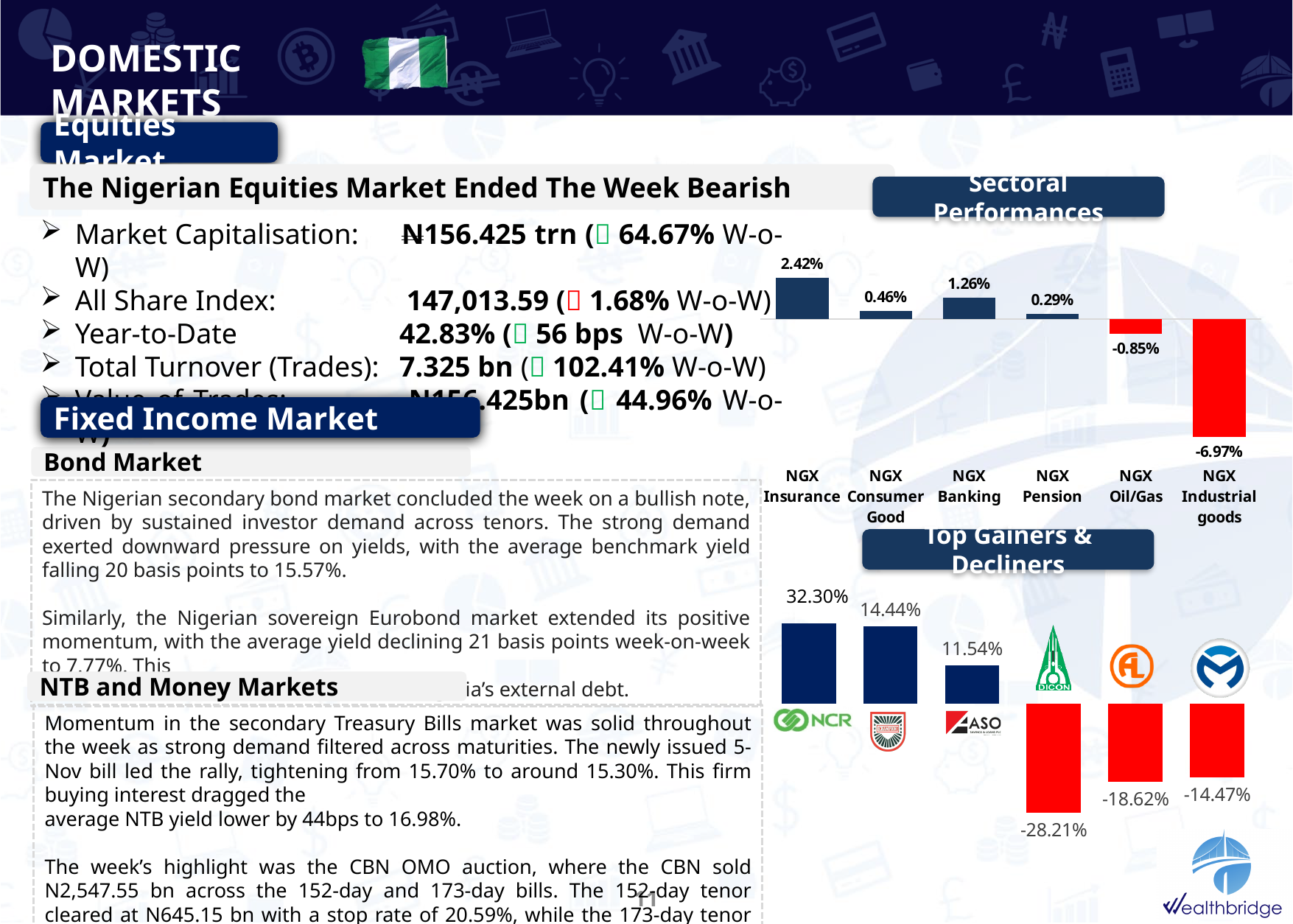
In the Sectoral Performances chart, what is the value for NGX Insurance? 2.42% In the Top Gainers & Decliners chart, what is the value for the bar labelled with the ASO logo? 11.54% How many sectors are shown in the Sectoral Performances chart? 6 In the Top Gainers & Decliners chart, what is the highest value shown? 32.30% In the Sectoral Performances chart, which is larger, the value for NGX Consumer Good or NGX Banking? NGX Banking In the Sectoral Performances chart, which sector has the highest value? NGX Insurance In the Sectoral Performances chart, what is the value for NGX Oil/Gas? -0.85% In the Sectoral Performances chart, what is the difference between the values for NGX Banking and NGX Pension? 0.97% In the Top Gainers & Decliners chart, what is the lowest value shown? -28.21% In the Sectoral Performances chart, what is the value for NGX Industrial goods? -6.97% In the Sectoral Performances chart, which sector has the lowest value? NGX Industrial goods What kind of chart is the Sectoral Performances chart? Bar chart